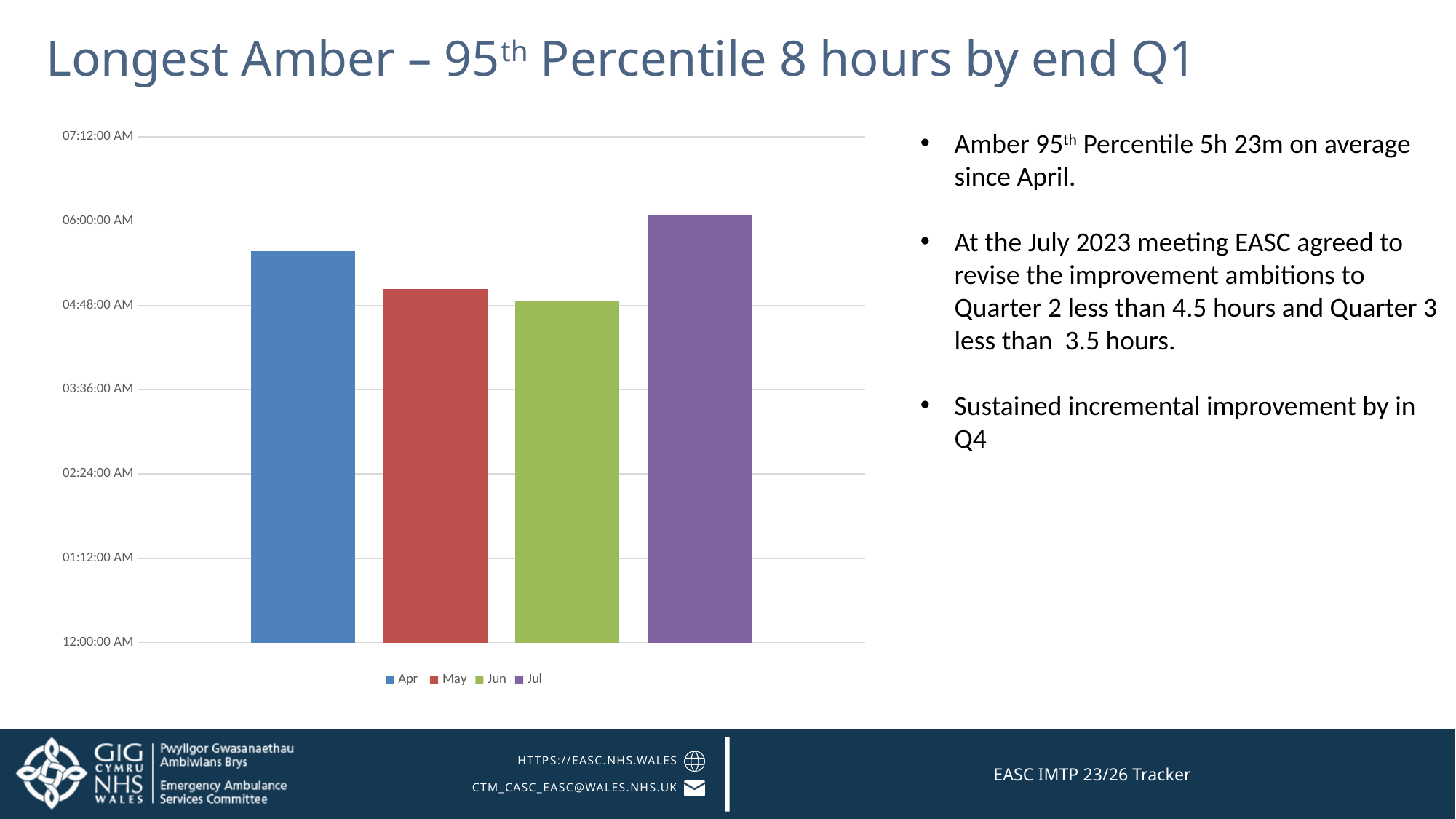
How many series does the chart legend list? 4 Which is larger, the value for Apr or the value for Jul? Jul How many bars are plotted in the chart? 4 Which month has the highest bar in the chart? Jul Is the value for Apr greater or less than 04:48:00 AM? greater Is the value for Jun greater or less than 06:00:00 AM? less What colour is the bar for Jul in the chart? purple Do the values rise or fall from Apr to Jun? fall Is the value for Apr greater or less than 06:00:00 AM? less Which is larger, the value for Apr or the value for May? Apr What kind of chart is shown on the slide? bar chart Which is larger, the value for Jun or the value for Jul? Jul